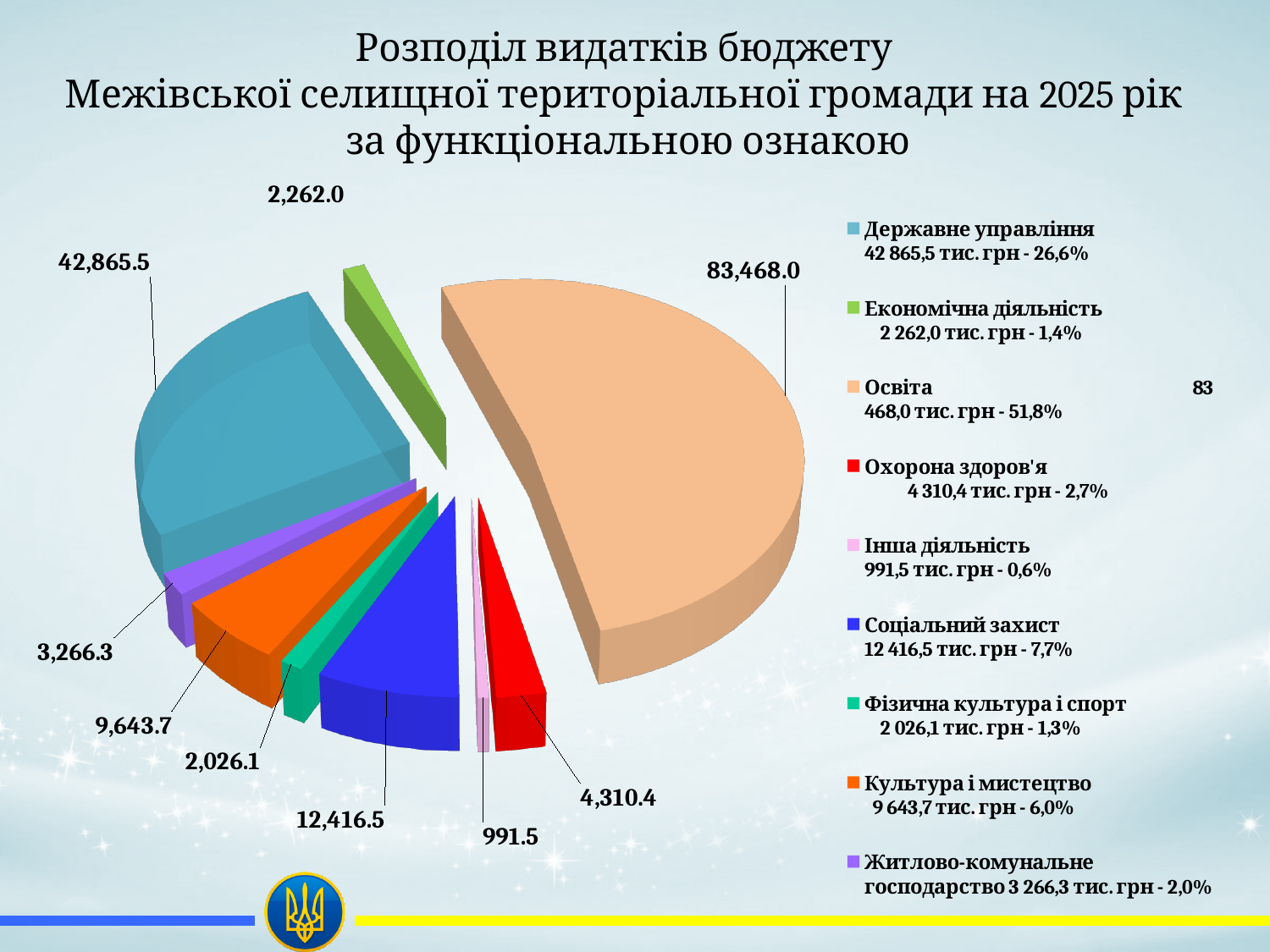
What is the value for Освіта? 83,468.0 What is the value for Інша діяльність? 991.5 What share of the pie does Освіта represent, according to the legend? 51,8% What colour is the slice for Охорона здоров'я? red What is the value for Державне управління? 42,865.5 What is the value for Соціальний захист? 12,416.5 Which category has the largest slice? Освіта Which is larger, Культура і мистецтво or Соціальний захист? Соціальний захист How many categories does the pie chart have? 9 What kind of chart is shown on the slide? pie chart What is the difference between the values for Освіта and Державне управління? 40,602.5 Which category has the smallest slice? Інша діяльність